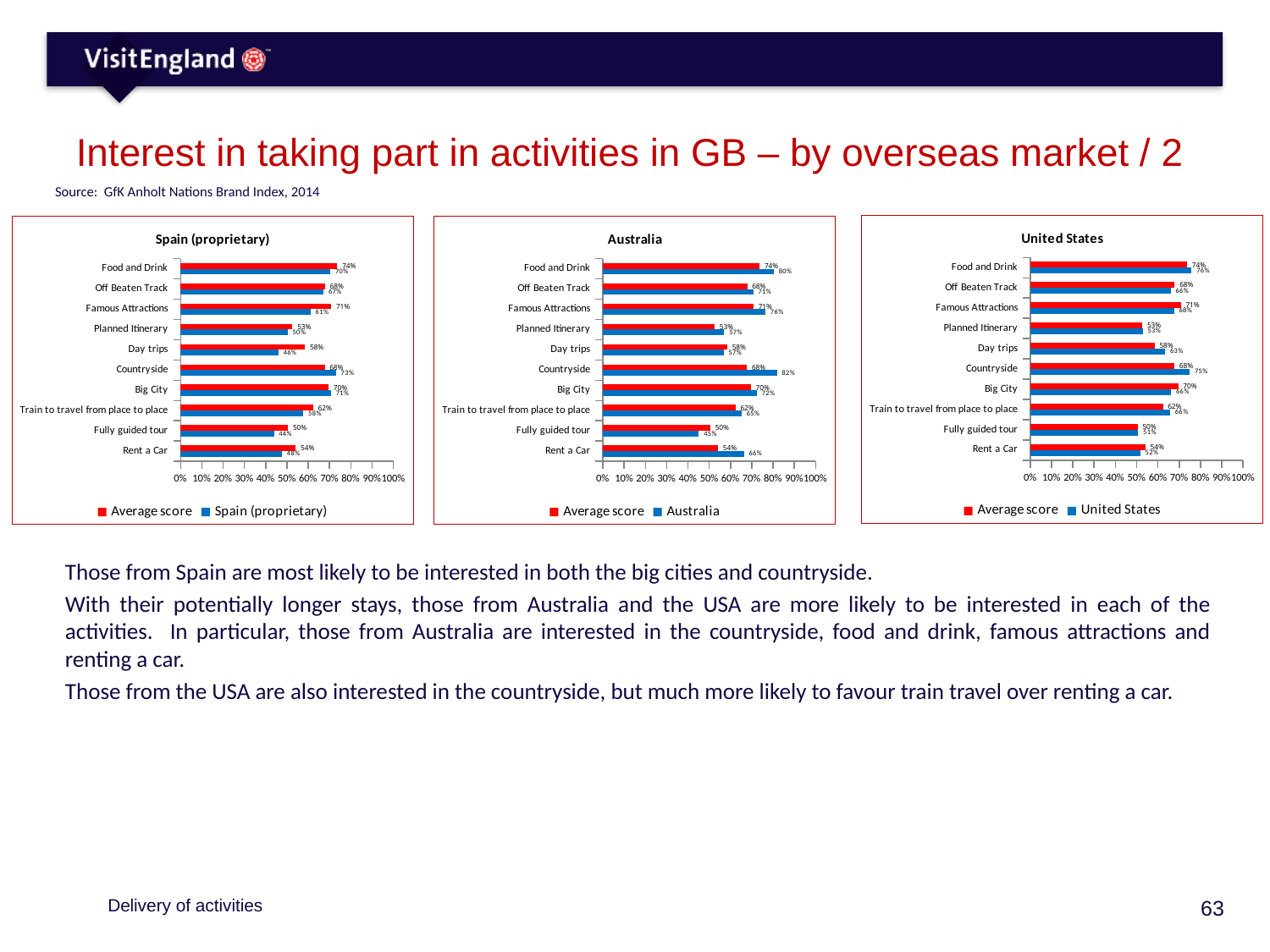
In the Australia chart, which activity has the highest Australia value? Countryside In the Australia chart, what is the Australia value for Countryside? 82% In the Spain (proprietary) chart, is the Spain (proprietary) value for Day trips greater or less than 50%? less How many activities are listed on the Australia chart? 10 In the United States chart, which is larger for Countryside: the United States value or the Average score? United States How many series does the legend of the United States chart list? 2 In the Australia chart, which colour represents the Average score series? Red What type of chart is the Spain (proprietary) chart? Bar chart In the Spain (proprietary) chart, which activity has the lowest Spain (proprietary) value? Fully guided tour In the Australia chart, what is the difference between the Australia value and the Average score for Rent a Car? 12% In the United States chart, what is the United States value for Food and Drink? 76% In the Spain (proprietary) chart, what is the Spain (proprietary) value for Countryside? 73%